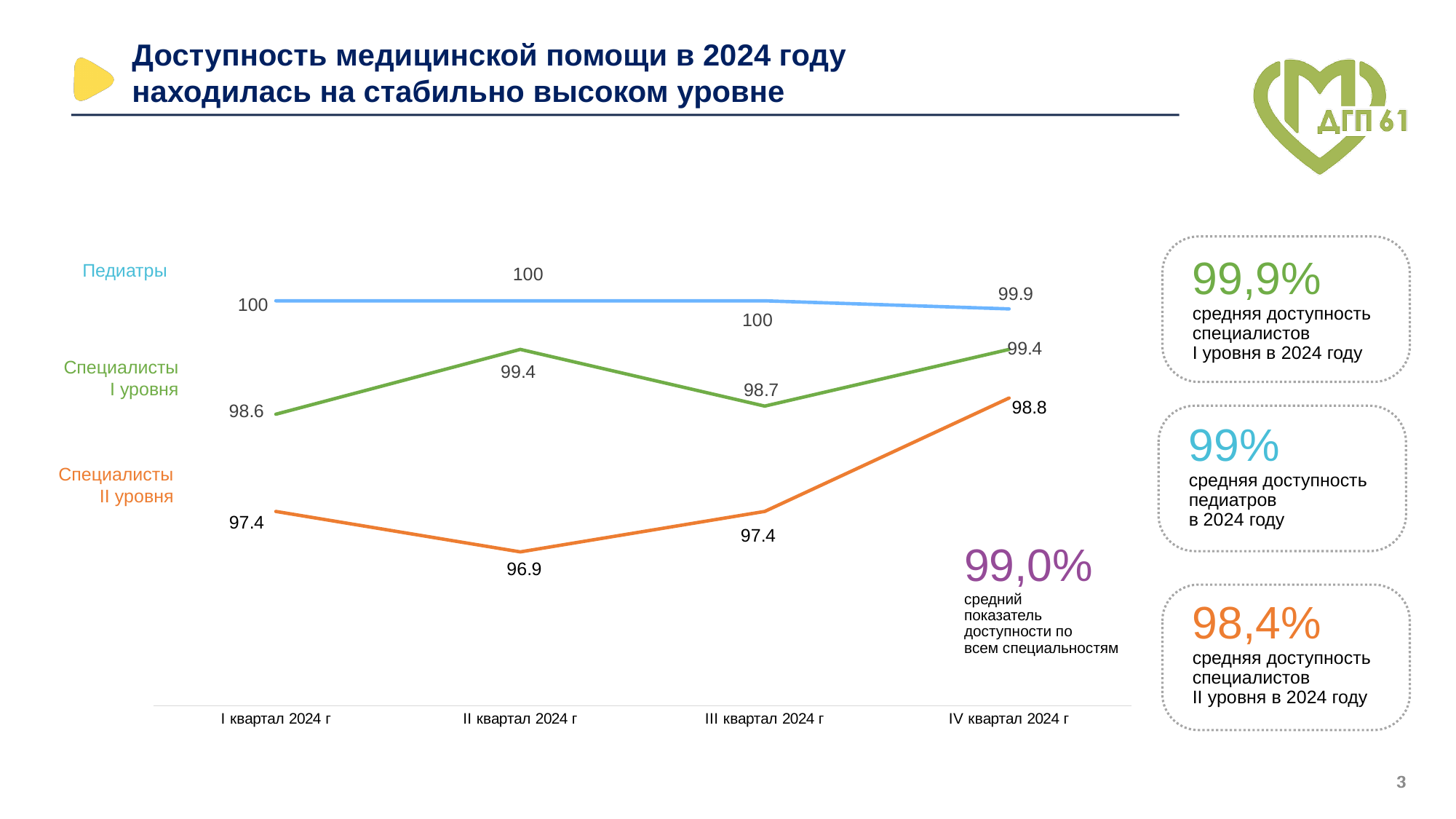
How many quarters are shown on the x axis of the chart? 4 How many series are plotted on the chart? 3 Does the value for Специалисты II уровня rise or fall from III квартал 2024 г to IV квартал 2024 г? rise What is the value for Специалисты I уровня in III квартал 2024 г? 98.7 What is the value for Специалисты II уровня in II квартал 2024 г? 96.9 In which quarter is the value for Специалисты II уровня the lowest? II квартал 2024 г What kind of chart is shown on the slide? line chart What is the value for Педиатры in I квартал 2024 г? 100 Which series has the larger value in IV квартал 2024 г: Специалисты I уровня or Специалисты II уровня? Специалисты I уровня What is the difference between Специалисты I уровня and Специалисты II уровня in I квартал 2024 г? 1.2 What is the value for Педиатры in IV квартал 2024 г? 99.9 In which quarter is the value for Специалисты II уровня the highest? IV квартал 2024 г